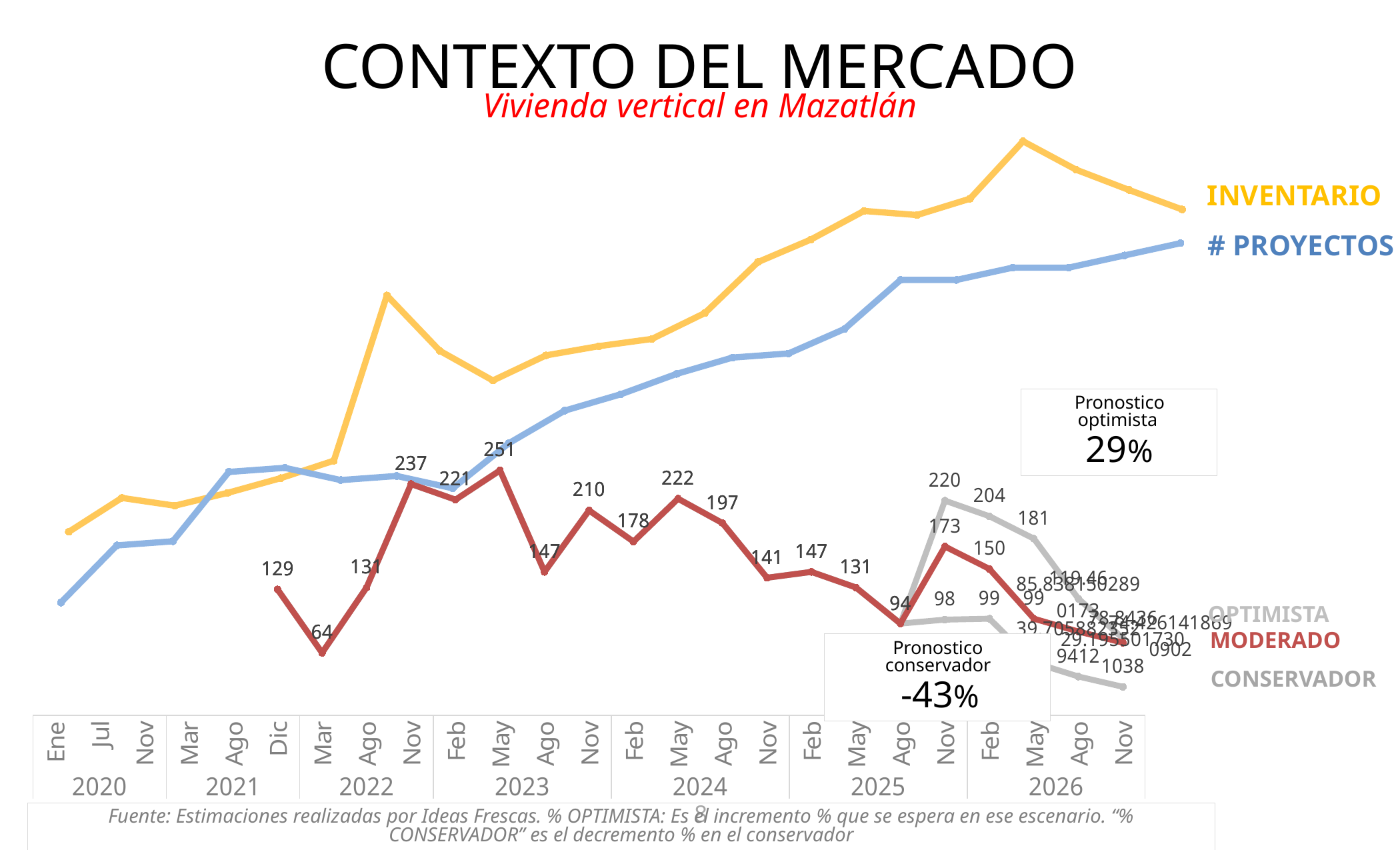
What is the OPTIMISTA value for Nov 2025? 220 In which month and year does the MODERADO series reach its highest labelled value? May 2023 Does the INVENTARIO line generally rise or fall from 2020 to 2025? rise What is the difference between the MODERADO values for Nov 2022 (237) and Feb 2023 (221)? 16 What is the MODERADO value for Mar 2022? 64 What kind of chart is shown on the slide? line chart Which is larger, the MODERADO value for Nov 2025 or the OPTIMISTA value for Nov 2025? OPTIMISTA (220) What is the MODERADO value for May 2023? 251 How many series are labelled on the chart? 5 What percentage is shown in the 'Pronostico conservador' box? -43% What is the MODERADO value for Ago 2025? 94 In which month and year does the MODERADO series reach its lowest labelled value? Mar 2022